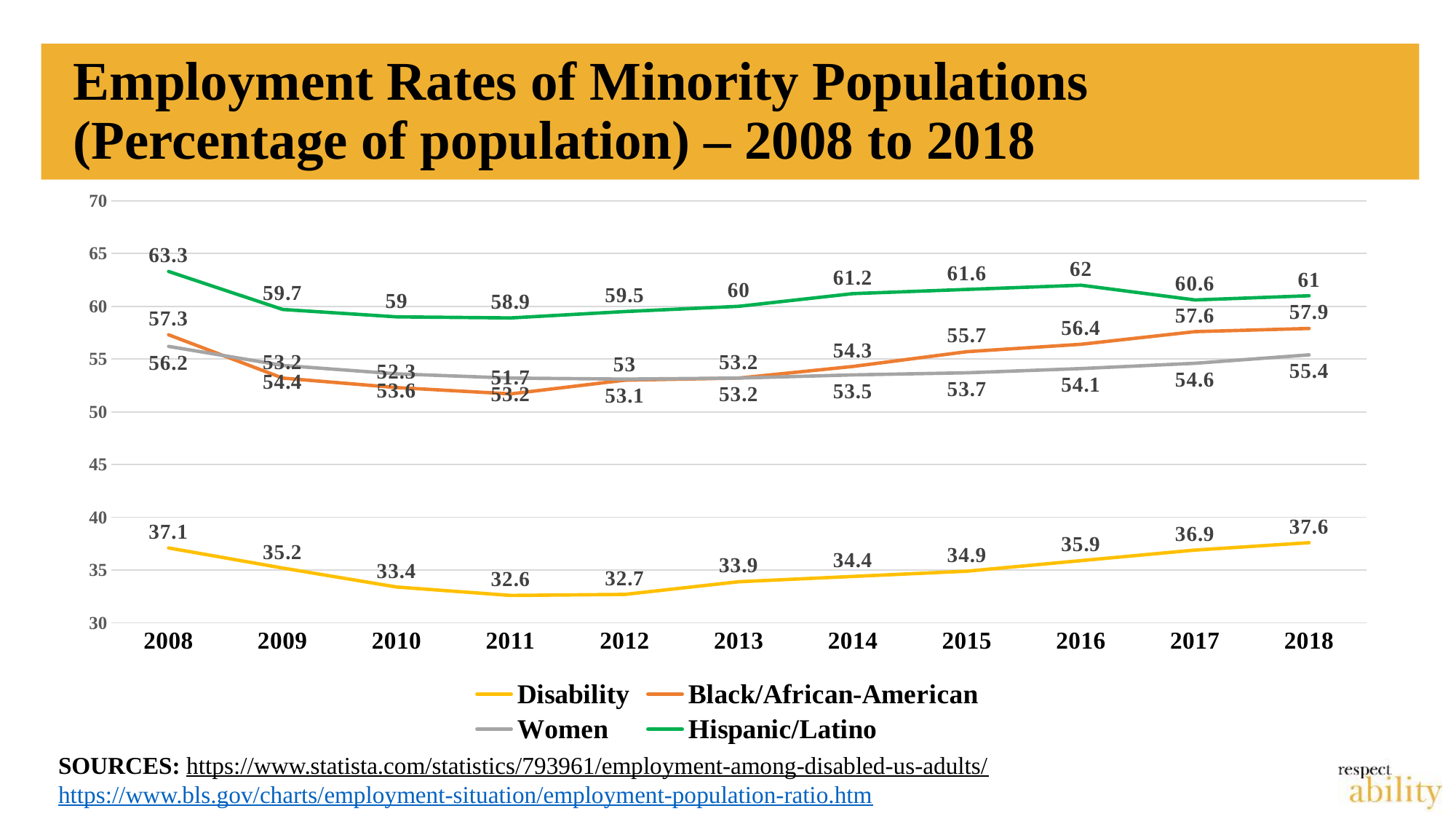
Does the Disability employment rate rise or fall from 2011 to 2018? rise How many years are plotted along the x axis? 11 What is the Black/African-American employment rate in 2017? 57.6 What is the Hispanic/Latino employment rate in 2008? 63.3 What is the difference between the Disability employment rate in 2008 and in 2011? 4.5 How many series does the legend list? 4 In 2016, which is higher: the Hispanic/Latino rate or the Black/African-American rate? Hispanic/Latino What kind of chart is shown on the slide? line chart In which year is the Disability employment rate lowest? 2011 What is the Women employment rate in 2018? 55.4 In which year is the Hispanic/Latino employment rate highest? 2008 What is the Disability employment rate in 2018? 37.6